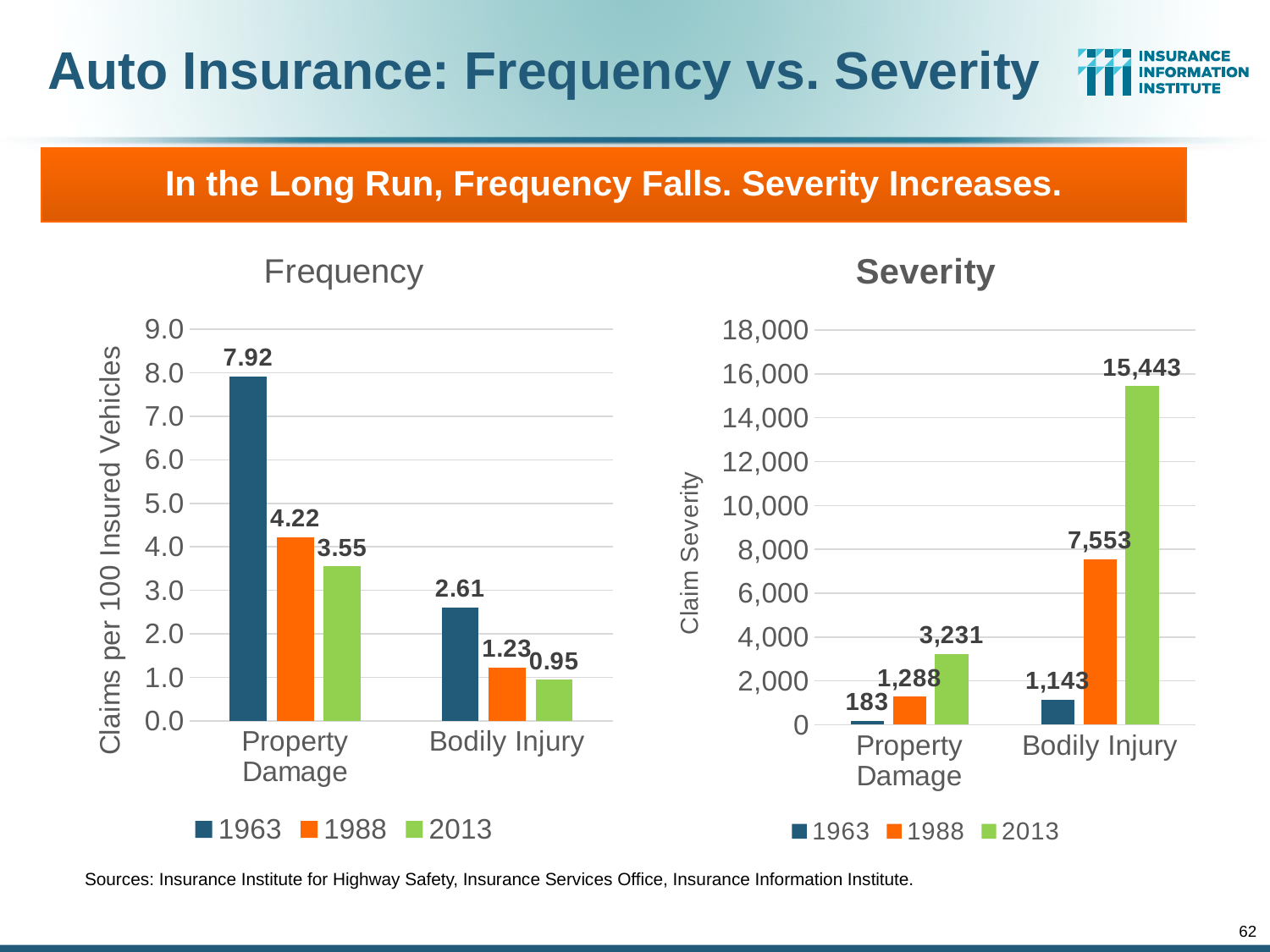
In the Frequency chart, which year has the highest value for Property Damage? 1963 In the Frequency chart, do the values for Bodily Injury rise or fall from 1963 to 2013? fall In the Severity chart, which is larger: Property Damage in 2013 or Bodily Injury in 1988? Bodily Injury in 1988 In the Frequency chart, what is the value for Property Damage in 1963? 7.92 In the Frequency chart, what is the difference between the 1963 and 1988 values for Property Damage? 3.70 In the Severity chart, which year has the lowest value for Bodily Injury? 1963 What kind of chart is the Frequency chart? bar chart In the Severity chart, what is the difference between the 2013 and 1988 values for Bodily Injury? 7,890 In the Severity chart, what is the claim severity for Property Damage in 1963? 183 In the Severity chart, what is the claim severity for Bodily Injury in 2013? 15,443 In the Frequency chart, what is the value for Bodily Injury in 2013? 0.95 How many series does the legend of the Severity chart list? 3